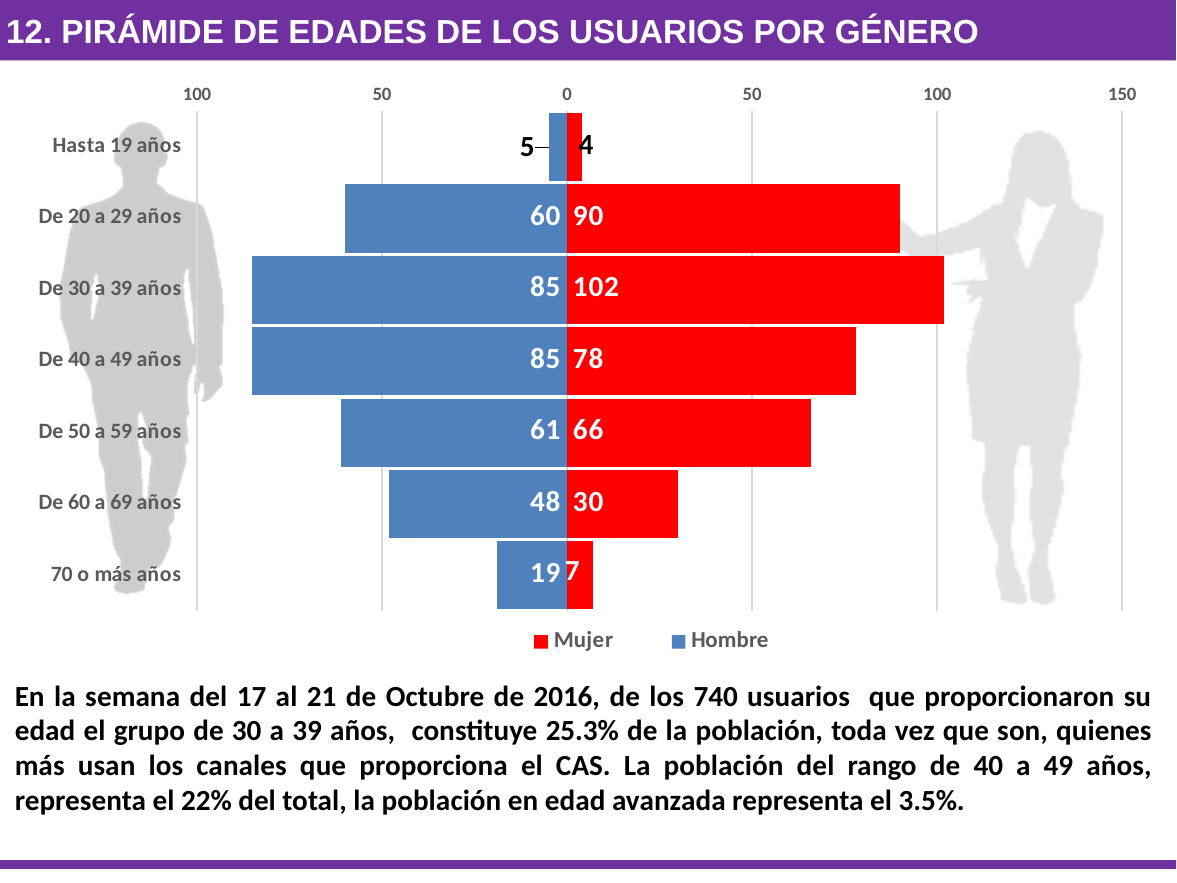
Which age group has the highest Mujer value? De 30 a 39 años Which colour represents the Mujer series in the chart? Red How many age groups are shown in the chart? 7 What kind of chart is shown on the slide? Bar chart Which age group has the lowest Hombre value? Hasta 19 años What is the total of Hombre and Mujer for the 'De 50 a 59 años' age group? 127 What is the Mujer value for the 'De 30 a 39 años' age group? 102 What is the difference between the Mujer and Hombre values for the 'De 20 a 29 años' age group? 30 What is the Hombre value for the 'De 60 a 69 años' age group? 48 What is the Hombre value for the '70 o más años' age group? 19 How many series does the legend list? 2 For the 'De 40 a 49 años' age group, which is larger, the Hombre value or the Mujer value? Hombre